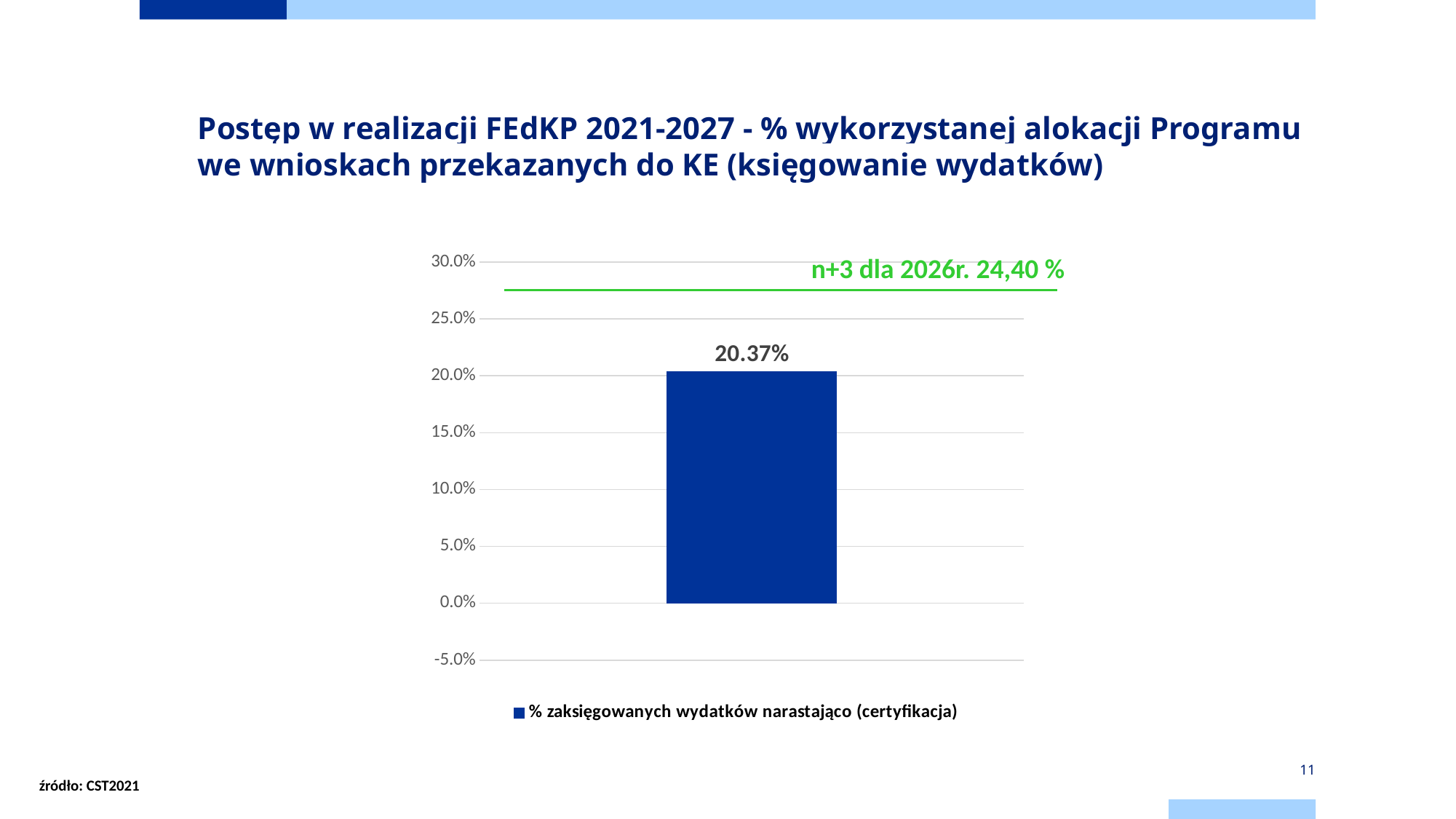
Is the value of the bar greater or less than 25.0%? less What is the legend entry for the series in the chart? % zaksięgowanych wydatków narastająco (certyfikacja) How many bars are plotted in the chart? 1 What kind of chart is shown on the slide? Bar chart What is the highest tick value shown on the vertical axis of the chart? 30.0% What is the difference between the n+3 target for 2026 (24,40 %) and the bar value (20.37%)? 4.03 percentage points What value is shown on the data label of the bar in the chart? 20.37% Is the value of the bar greater or less than 15.0%? greater What is the n+3 target value for 2026 shown above the green line in the chart? 24,40 % How many series does the chart legend list? 1 Which is larger: the plotted bar value or the n+3 target for 2026 shown by the green line? The n+3 target (24,40 %)